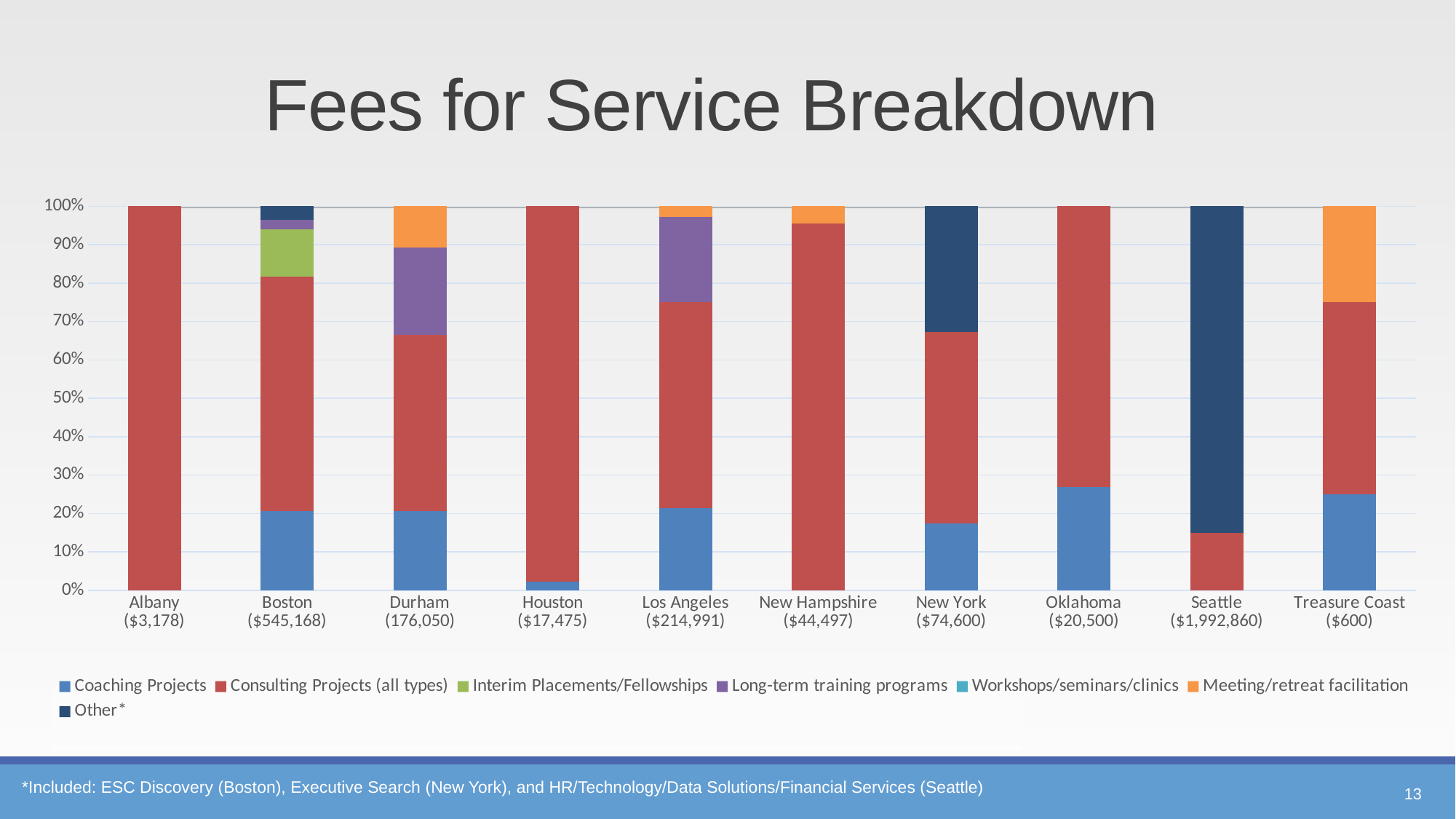
How many series does the legend list? 7 What is the difference between the fee amounts shown for Boston ($545,168) and Albany ($3,178)? $541,990 What total fee amount is shown in the axis label for Seattle? $1,992,860 What total fee amount is shown in the axis label for Boston? $545,168 What kind of chart is shown on the slide? Stacked bar chart Is the Other* share for Seattle greater or less than 70%? greater Which city has the largest total fee amount shown in its axis label? Seattle How many cities (categories) are shown on the x axis? 10 Is the Coaching Projects share for Oklahoma greater or less than 20%? greater Which city has a larger Coaching Projects share, Oklahoma or New York? Oklahoma Which city has the smallest total fee amount shown in its axis label? Treasure Coast What is the title of the chart? Fees for Service Breakdown